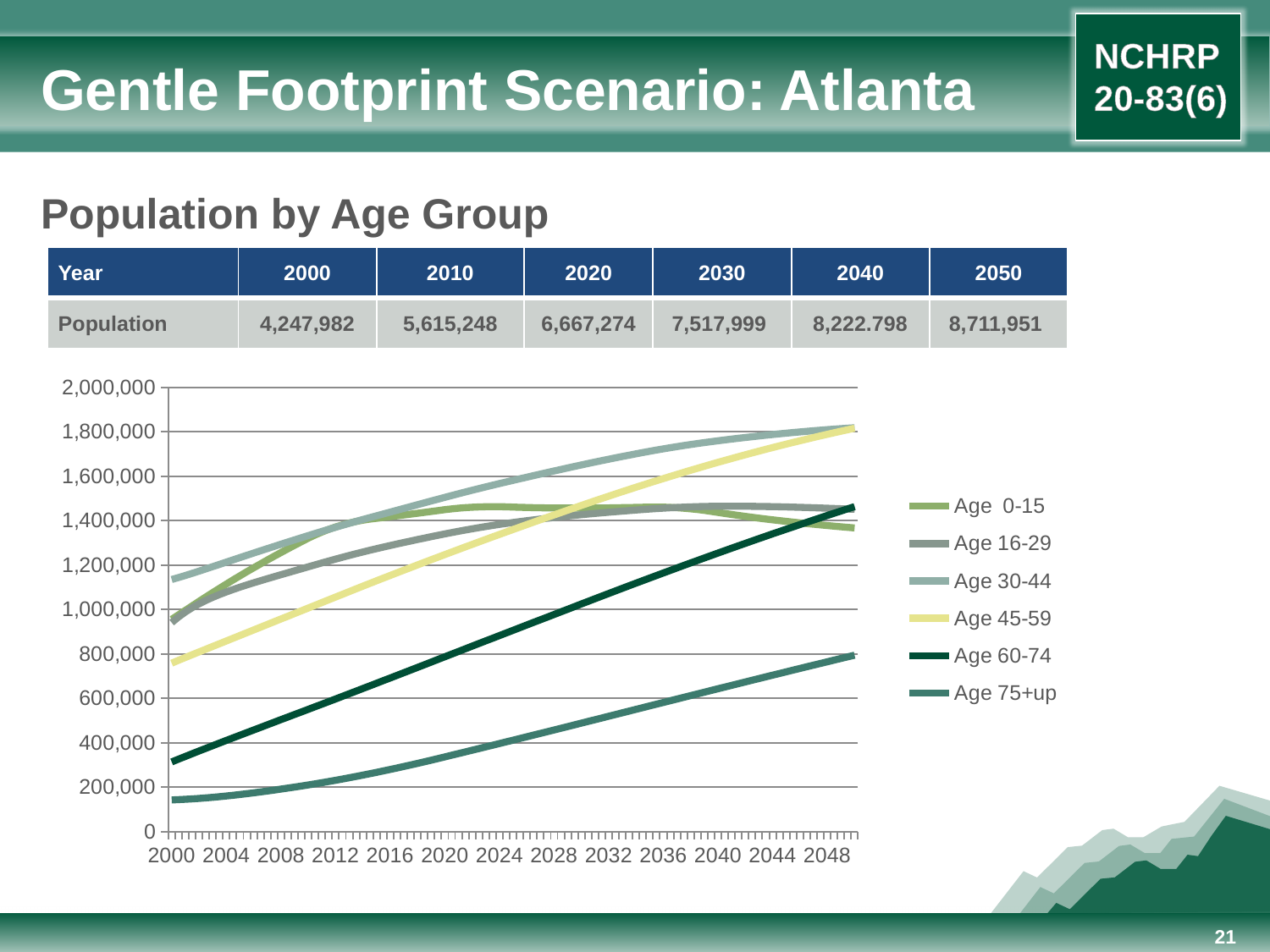
Does the Age 75+up line rise or fall across the years shown? rise Which age group has the lowest value in 2000? Age 75+up At the right end of the chart (2048), which is larger: Age 60-74 or Age 75+up? Age 60-74 Is the value for Age 75+up in 2000 greater or less than 200,000? less Is the value for Age 30-44 at the right end of the chart (2048) greater or less than 1,600,000? greater Which age group has the highest value in 2000? Age 30-44 Is the value for Age 45-59 in 2000 greater or less than 1,000,000? less How many series does the chart's legend list? 6 Does the Age 60-74 line rise or fall from 2000 to 2048? rise What kind of chart is shown on the slide? line chart Which age group series is shown in the darkest green line according to the legend? Age 60-74